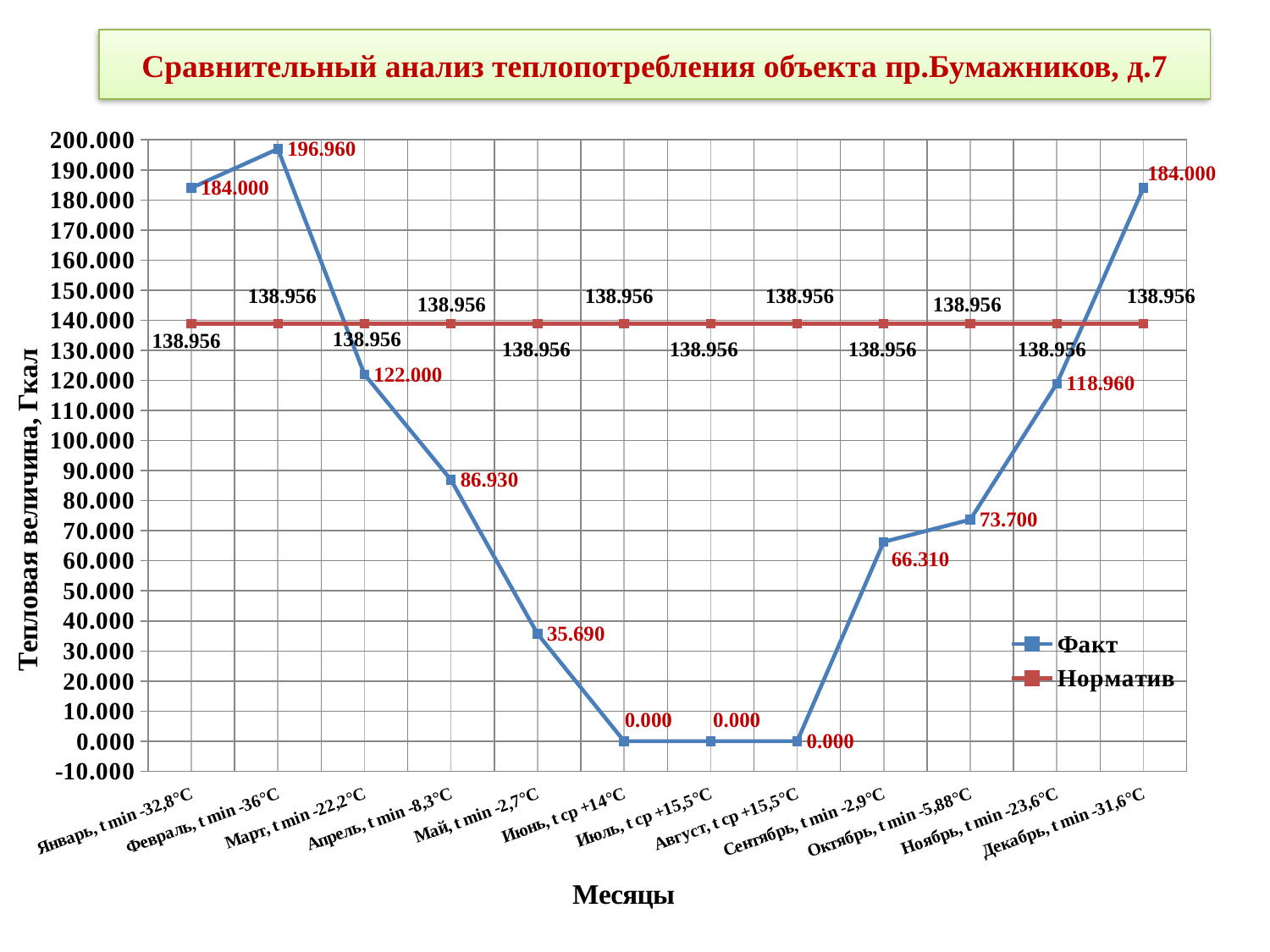
Does the Факт series rise or fall from Январь to Июнь? fall What is the difference between the Норматив value and the Факт value for Ноябрь, t min -23,6°C? 19.996 What is the Факт value for Февраль, t min -36°C? 196.960 How many months are plotted on the x axis? 12 What is the difference between the Факт values for Февраль, t min -36°C and Март, t min -22,2°C? 74.960 What is the Факт value for Апрель, t min -8,3°C? 86.930 Is the Факт value for Май, t min -2,7°C greater or less than 40.000? less Which is larger, the Факт value for Октябрь, t min -5,88°C or the Факт value for Сентябрь, t min -2,9°C? Октябрь, t min -5,88°C What is the Норматив value for Сентябрь, t min -2,9°C? 138.956 What kind of chart is shown on the slide? line chart Which month has the highest Факт value? Февраль, t min -36°C How many series does the legend list? 2